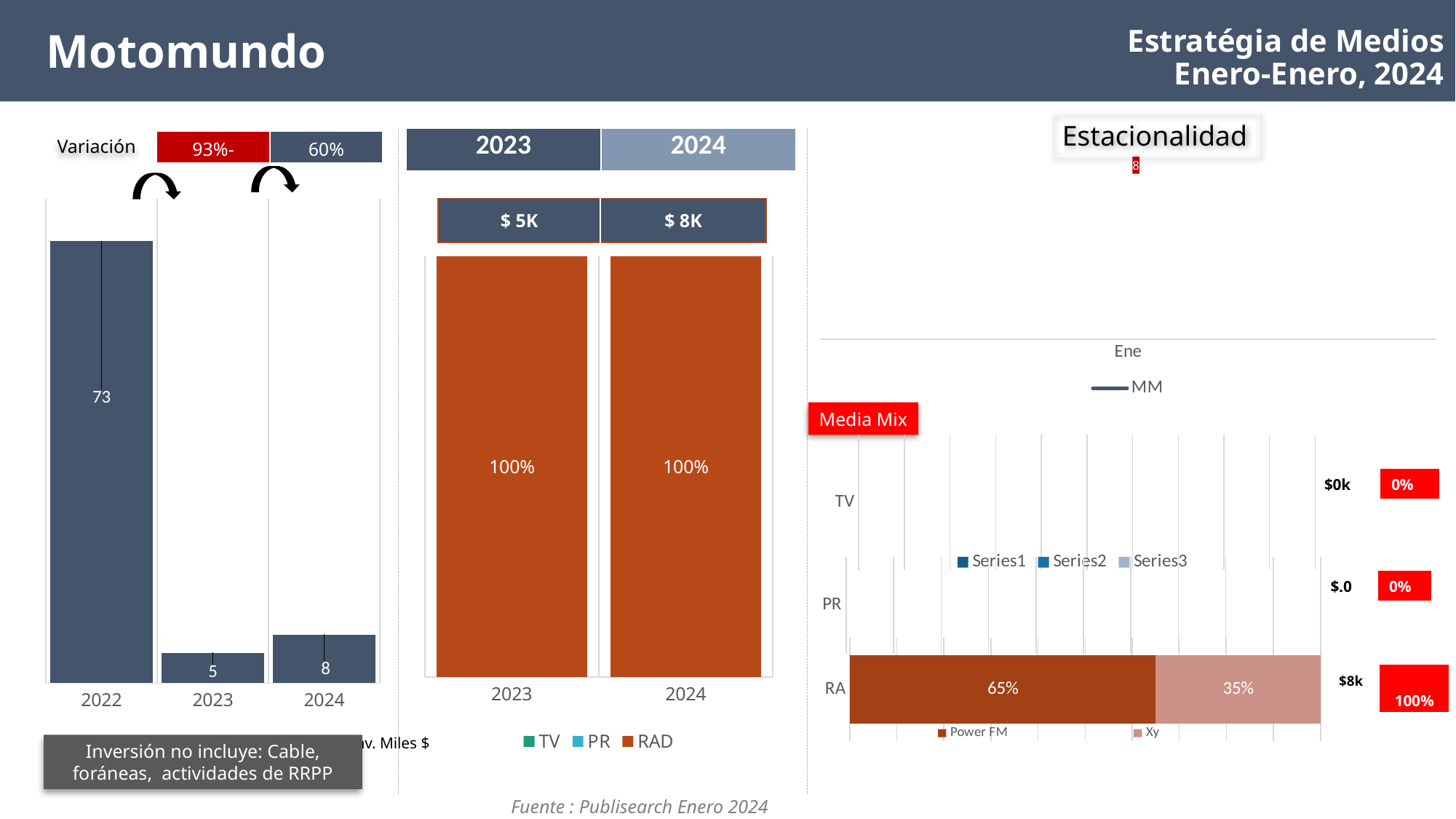
In the Media Mix chart, what share does Power FM have in the RA bar? 65% In the left bar chart of investment by year, what is the value for 2024? 8 In the left bar chart of investment by year, which year has the lowest value? 2023 In the left bar chart of investment by year, what is the value for 2023? 5 In the Media Mix chart, which is larger in the RA bar, Power FM or Xy? Power FM In the left bar chart of investment by year, what is the difference between the 2022 and 2024 values? 65 In the left bar chart of investment by year, what is the value for 2022? 73 In the middle stacked bar chart by media type, what share does RAD have in 2024? 100% In the middle stacked bar chart by media type, what is the total shown above the 2023 bar? $ 5K In the middle stacked bar chart by media type, how many series does the legend list? 3 In the left bar chart of investment by year, how many years are shown? 3 In the left bar chart of investment by year, which year has the highest value? 2022